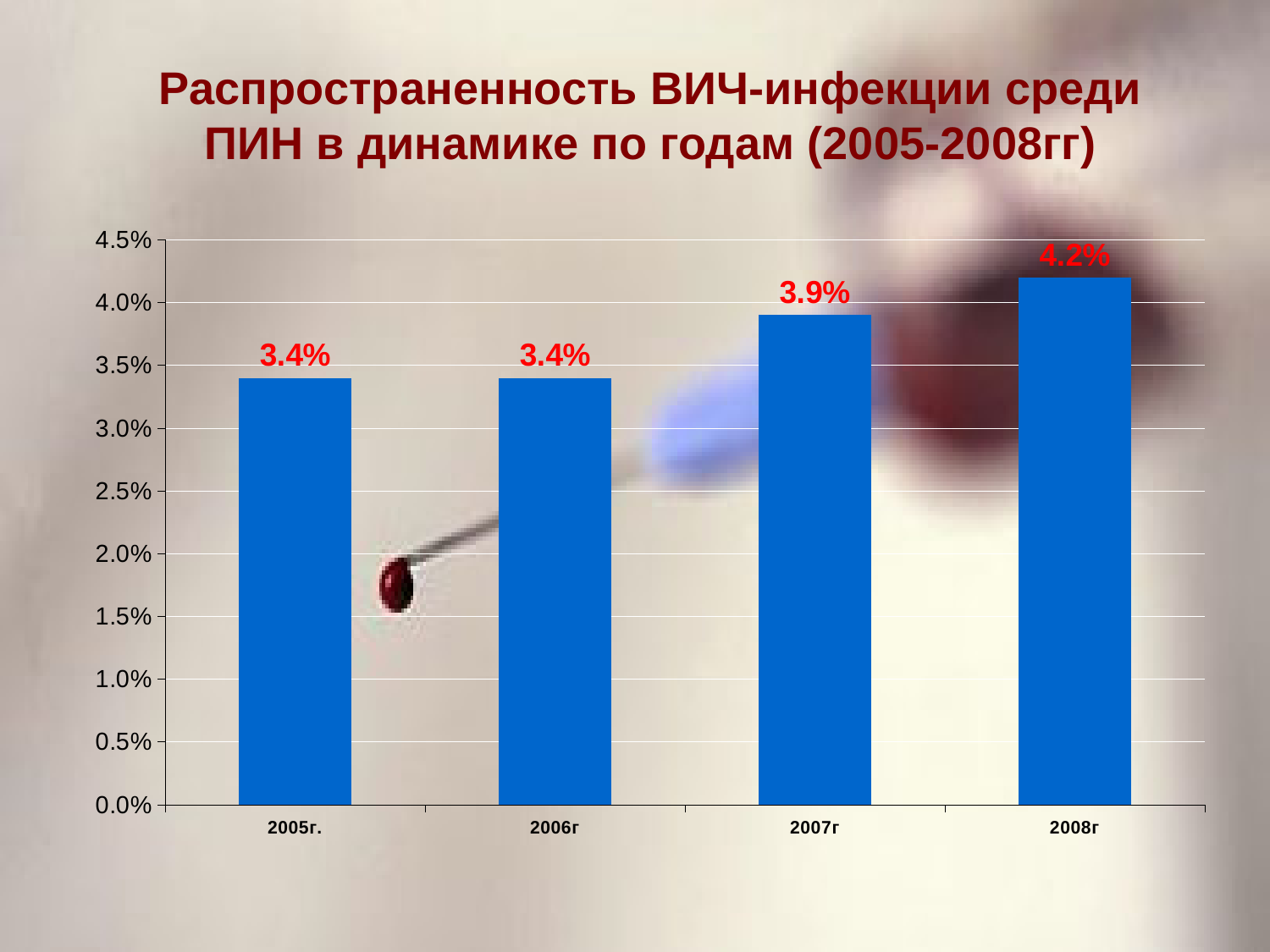
Is the value for 2008г greater or less than 4.0%? greater What is the difference between the values for 2008г and 2007г? 0.3% What colour are the bars in the chart? blue How many years are shown on the chart? 4 What kind of chart is shown on the slide? bar chart What is the value for 2005г.? 3.4% What is the value for 2008г? 4.2% Do the values rise or fall from 2006г to 2008г? rise What is the difference between the values for 2007г and 2006г? 0.5% Which year has the highest value? 2008г Which is larger, the value for 2007г or the value for 2006г? 2007г What is the value for 2007г? 3.9%